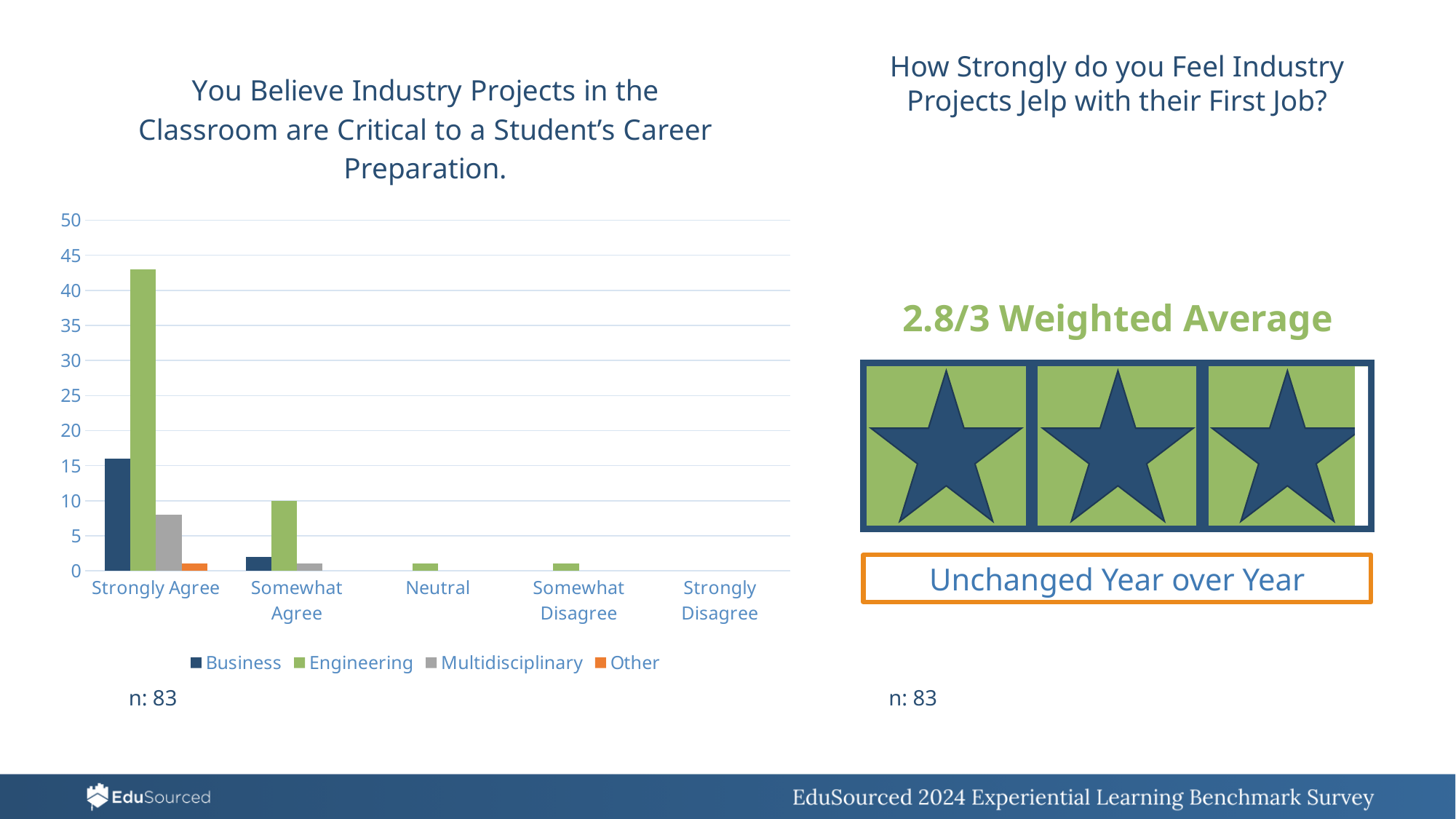
Which category has the highest Engineering bar? Strongly Agree Is the Engineering value for Strongly Agree greater or less than 40? greater Which series has the tallest bar in the Strongly Agree category? Engineering Which is larger in the Somewhat Agree category, the Business bar or the Engineering bar? Engineering Which series is shown in orange in the bar chart legend? Other Do the Engineering values rise or fall moving from Strongly Agree to Strongly Disagree along the x axis? fall How many response categories are shown on the x axis of the bar chart? 5 What kind of chart is shown on the left of the slide? bar chart How many series does the legend of the bar chart list? 4 What sample size (n) is stated below the bar chart? n: 83 Is the Multidisciplinary value for Strongly Agree greater or less than 5? greater Is the Business value for Strongly Agree greater or less than 20? less